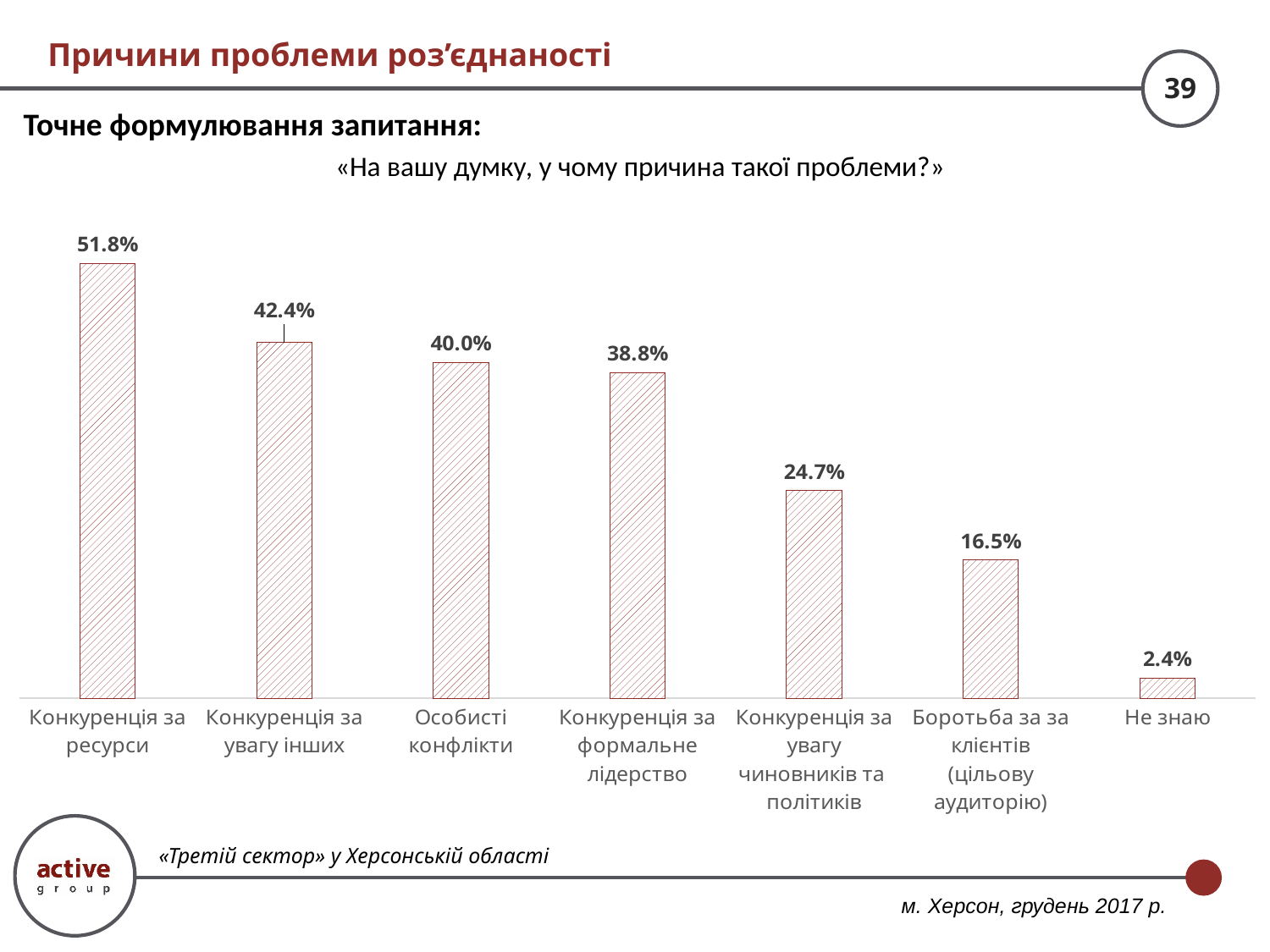
What is the difference between «Конкуренція за увагу чиновників та політиків» and «Боротьба за за клієнтів (цільову аудиторію)»? 8.2% Which is larger: «Особисті конфлікти» or «Конкуренція за формальне лідерство»? Особисті конфлікти How many categories are shown in the chart? 7 What is the value for «Конкуренція за ресурси»? 51.8% Do the values rise or fall from left to right along the x axis? Fall What is the difference between «Конкуренція за ресурси» and «Конкуренція за увагу інших»? 9.4% Which category has the lowest value? Не знаю Which category has the highest value? Конкуренція за ресурси What kind of chart is shown on the slide? Bar chart What is the value for «Особисті конфлікти»? 40.0% What is the value for «Боротьба за за клієнтів (цільову аудиторію)»? 16.5% What is the value for «Не знаю»? 2.4%